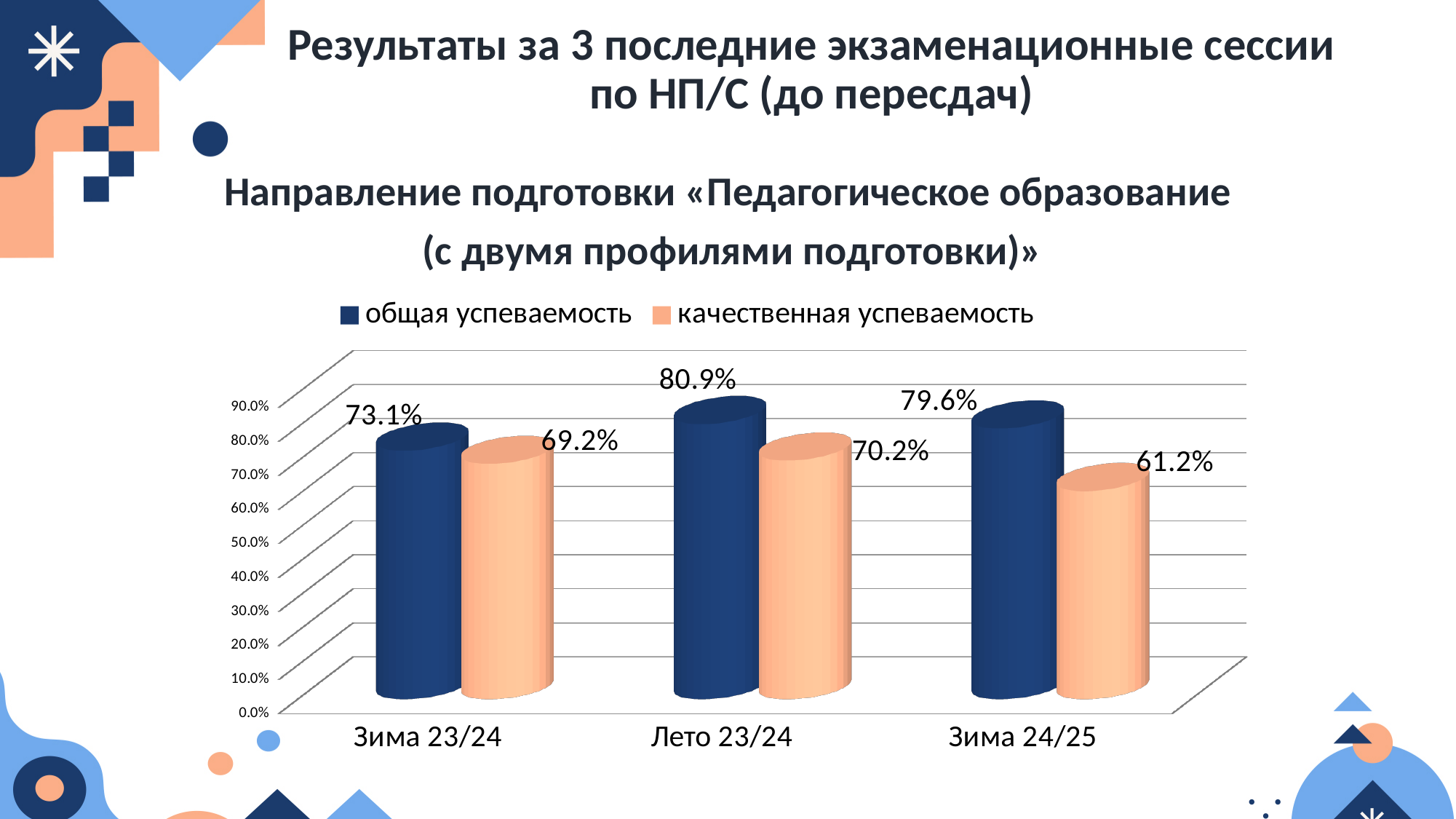
What is the value of общая успеваемость for Зима 23/24? 73.1% What is the value of качественная успеваемость for Зима 24/25? 61.2% What is the difference between общая успеваемость and качественная успеваемость for Зима 24/25? 18.4% How many series does the legend list? 2 Does качественная успеваемость rise or fall from Лето 23/24 to Зима 24/25? fall How many sessions (categories) are shown on the x axis? 3 Which is larger: общая успеваемость for Лето 23/24 or общая успеваемость for Зима 23/24? Лето 23/24 What is the value of качественная успеваемость for Лето 23/24? 70.2% Which colour represents общая успеваемость in the legend? dark blue What kind of chart is shown on the slide? bar chart In which session is качественная успеваемость the lowest? Зима 24/25 In which session is общая успеваемость the highest? Лето 23/24